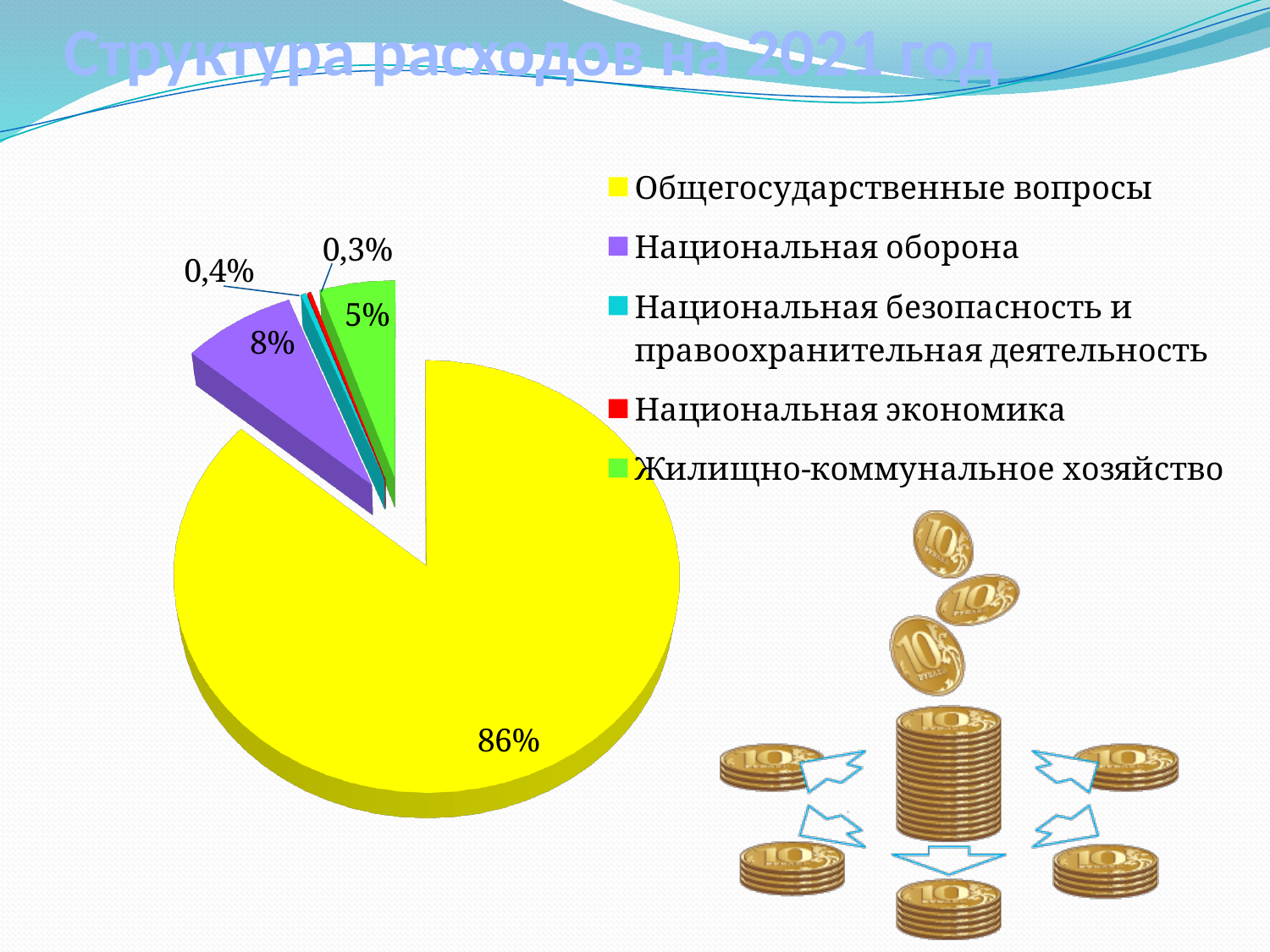
What share of the pie does Национальная оборона take? 8% What share of the pie does Национальная безопасность и правоохранительная деятельность take? 0,4% What share of the pie does Жилищно-коммунальное хозяйство take? 5% What is the difference between the share for Национальная оборона and the share for Жилищно-коммунальное хозяйство? 3% What kind of chart is shown on the slide? Pie chart Which is larger, the share for Национальная оборона or the share for Жилищно-коммунальное хозяйство? Национальная оборона What share of the pie does Национальная экономика take? 0,3% Which category has the smallest slice of the pie? Национальная экономика Which category has the largest slice of the pie? Общегосударственные вопросы What share of the pie does Общегосударственные вопросы take? 86% How many categories does the legend list? 5 What is the title of the slide's chart? Структура расходов на 2021 год